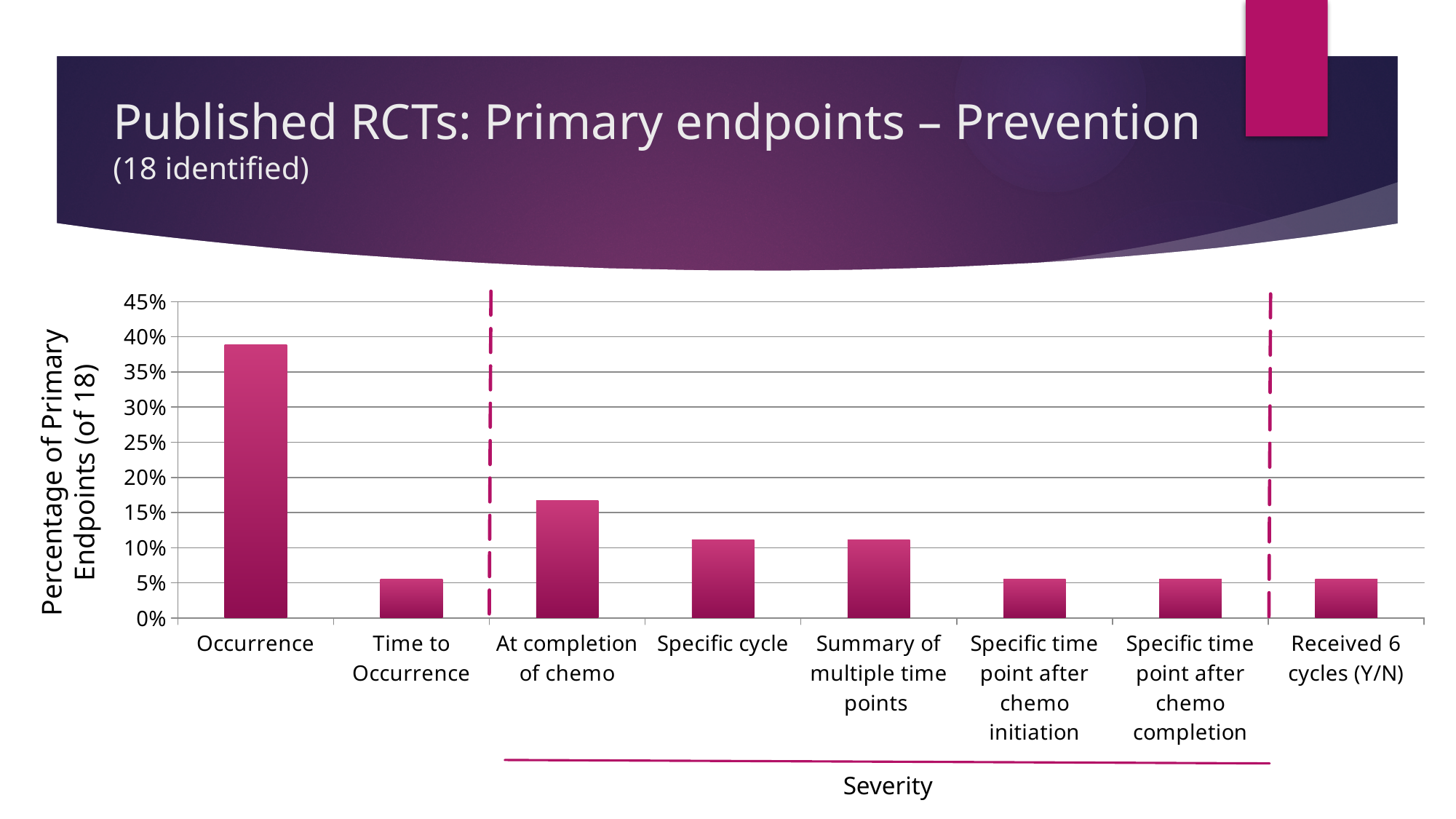
What kind of chart is shown on the slide? bar chart Which category has the highest percentage of primary endpoints? Occurrence Is the value for Specific cycle greater or less than 10%? greater What label appears under the bracket grouping the middle categories? Severity Is the value for Occurrence greater or less than 40%? less Is the value for Occurrence greater or less than 35%? greater How many categories are plotted on the x axis? 8 What is the title of the vertical axis? Percentage of Primary Endpoints (of 18) Which is larger, the value for At completion of chemo or the value for Specific cycle? At completion of chemo